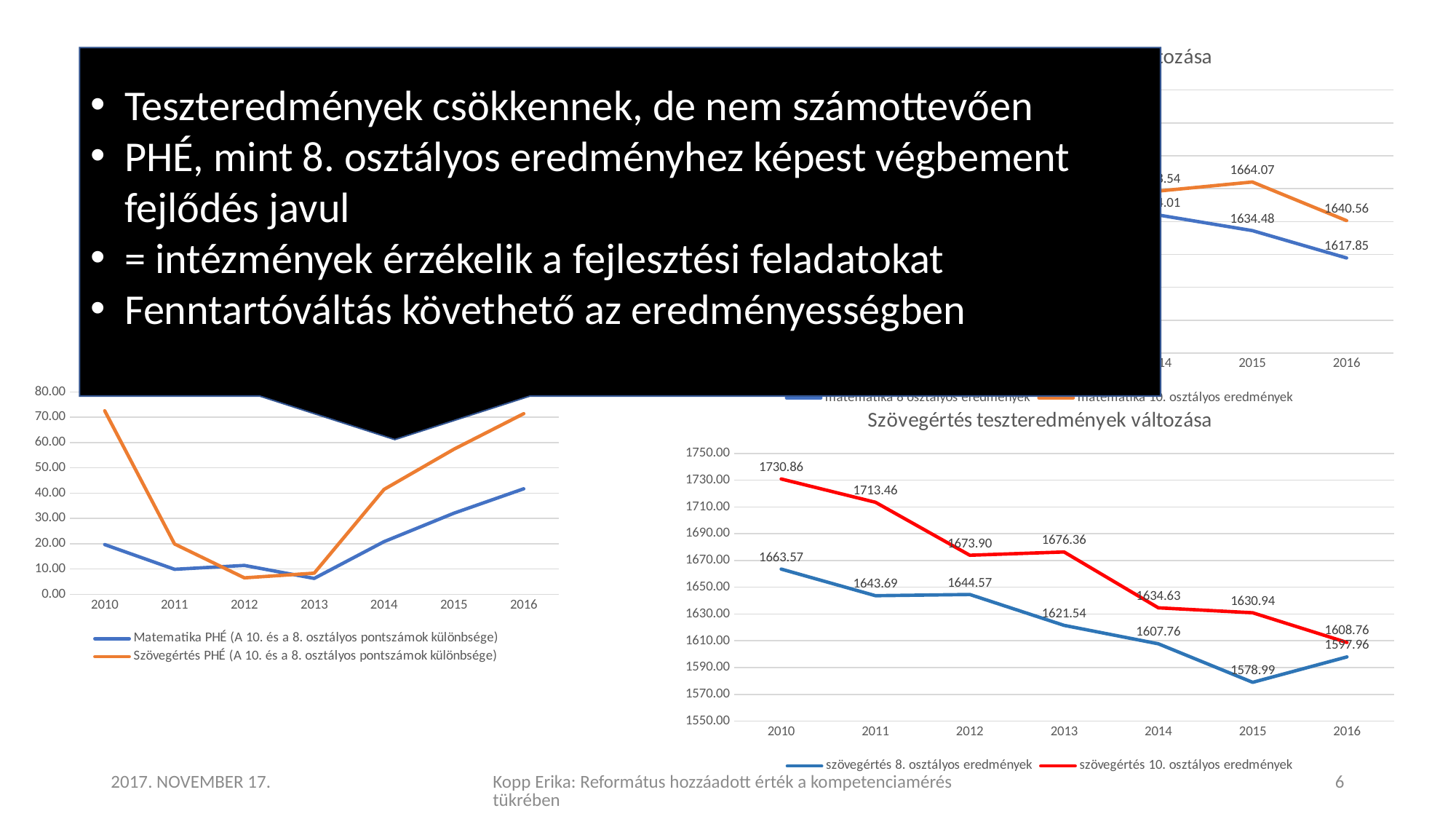
In the 'Szövegértés teszteredmények változása' chart, how many years are shown on the x axis? 7 In the 'Szövegértés teszteredmények változása' chart, what is the value for szövegértés 8. osztályos eredmények in 2015? 1578.99 In the 'Szövegértés teszteredmények változása' chart, what is the value for szövegértés 10. osztályos eredmények in 2010? 1730.86 In the 'Szövegértés teszteredmények változása' chart, which year has the lowest value for szövegértés 8. osztályos eredmények? 2015 In the 'Szövegértés teszteredmények változása' chart, what is the difference between the 10. osztályos and 8. osztályos values in 2016? 10.80 In the top-right chart, what is the value for matematika 10. osztályos eredmények in 2015? 1664.07 In the 'Szövegértés teszteredmények változása' chart, which year has the highest value for szövegértés 10. osztályos eredmények? 2010 In the 'Szövegértés teszteredmények változása' chart, do the values for szövegértés 10. osztályos eredmények generally rise or fall from 2010 to 2016? fall In the bottom-left chart, is the value for Szövegértés PHÉ in 2010 greater or less than 60.00? greater In the 'Szövegértés teszteredmények változása' chart, how many series does the legend list? 2 What kind of chart is the 'Szövegértés teszteredmények változása' chart? line chart In the 'Szövegértés teszteredmények változása' chart, which is larger in 2013: szövegértés 8. osztályos eredmények or szövegértés 10. osztályos eredmények? szövegértés 10. osztályos eredmények